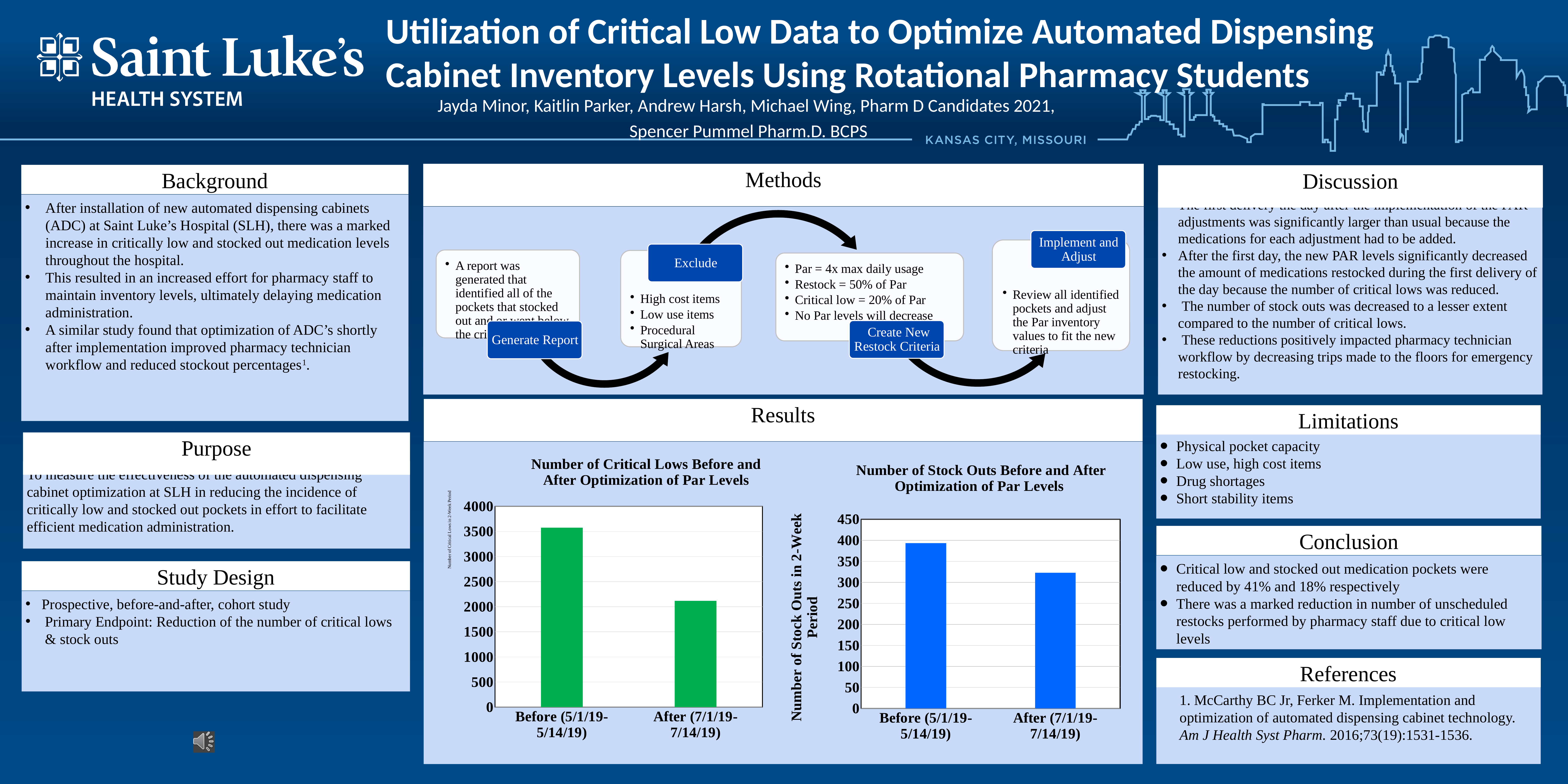
In the 'Number of Critical Lows Before and After Optimization of Par Levels' chart, do the values rise or fall from Before to After? fall What kind of chart is the 'Number of Critical Lows Before and After Optimization of Par Levels' chart? bar chart In the 'Number of Critical Lows Before and After Optimization of Par Levels' chart, is the value for After (7/1/19-7/14/19) greater or less than 2500? less In the 'Number of Stock Outs Before and After Optimization of Par Levels' chart, is the value for Before (5/1/19-5/14/19) greater or less than 350? greater In the 'Number of Critical Lows Before and After Optimization of Par Levels' chart, is the value for Before (5/1/19-5/14/19) greater or less than 3500? greater In the 'Number of Critical Lows Before and After Optimization of Par Levels' chart, which period has the higher value, Before (5/1/19-5/14/19) or After (7/1/19-7/14/19)? Before (5/1/19-5/14/19) What colour are the bars in the 'Number of Critical Lows Before and After Optimization of Par Levels' chart? green What is the y-axis label of the 'Number of Stock Outs Before and After Optimization of Par Levels' chart? Number of Stock Outs in 2-Week Period In the 'Number of Stock Outs Before and After Optimization of Par Levels' chart, which period has the lower value? After (7/1/19-7/14/19) How many bars are plotted in the 'Number of Critical Lows Before and After Optimization of Par Levels' chart? 2 What kind of chart is the 'Number of Stock Outs Before and After Optimization of Par Levels' chart? bar chart